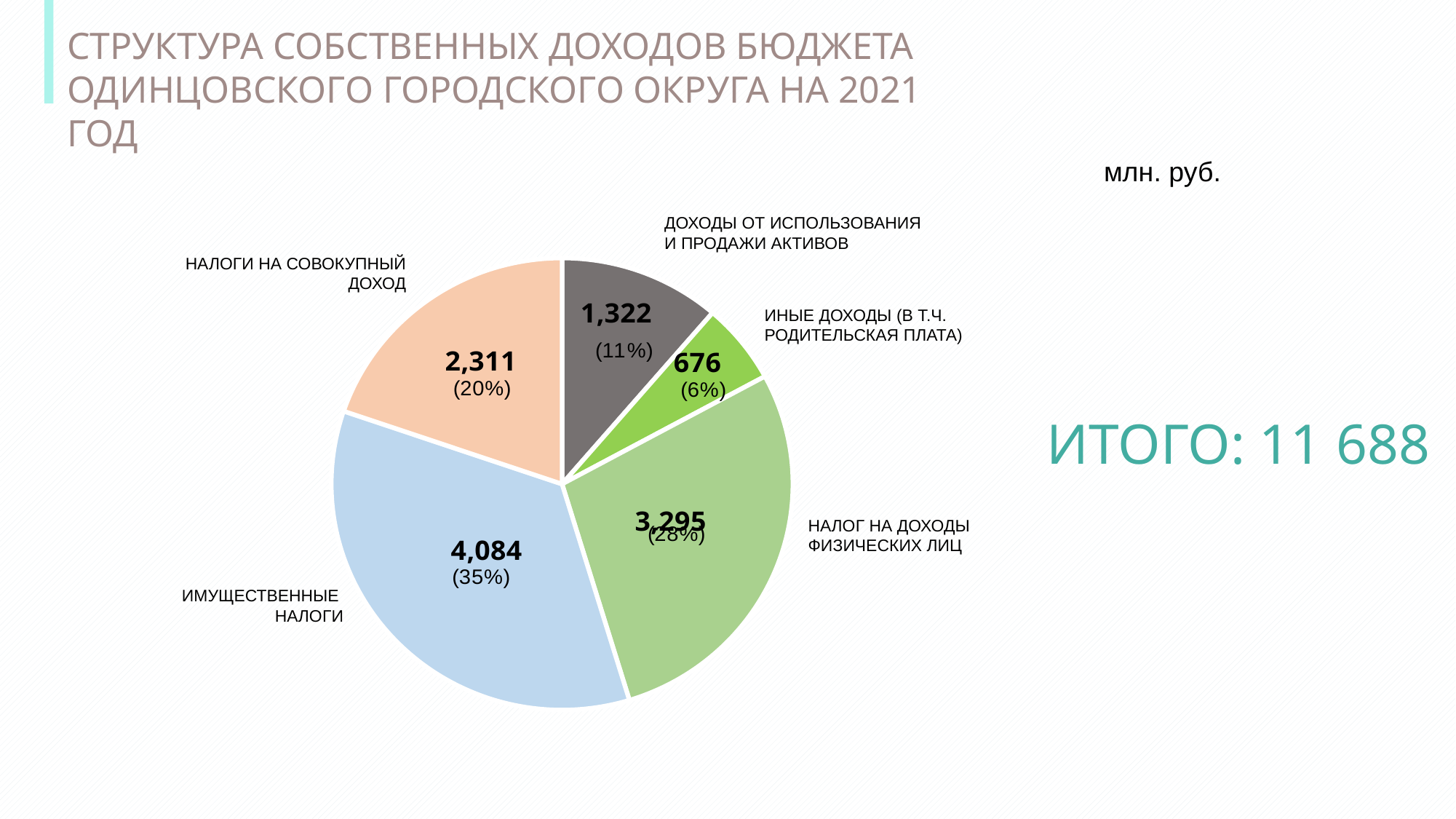
What is the value for НАЛОГ НА ДОХОДЫ ФИЗИЧЕСКИХ ЛИЦ? 3,295 Which category has the largest slice? ИМУЩЕСТВЕННЫЕ НАЛОГИ What is the value for ИМУЩЕСТВЕННЫЕ НАЛОГИ? 4,084 What is the value for ДОХОДЫ ОТ ИСПОЛЬЗОВАНИЯ И ПРОДАЖИ АКТИВОВ? 1,322 What share of the pie does НАЛОГ НА ДОХОДЫ ФИЗИЧЕСКИХ ЛИЦ represent? 28% Which is larger, the value for НАЛОГИ НА СОВОКУПНЫЙ ДОХОД or the value for ДОХОДЫ ОТ ИСПОЛЬЗОВАНИЯ И ПРОДАЖИ АКТИВОВ? НАЛОГИ НА СОВОКУПНЫЙ ДОХОД What is the value for НАЛОГИ НА СОВОКУПНЫЙ ДОХОД? 2,311 How many slices does the pie chart have? 5 What is the difference between the values for ИМУЩЕСТВЕННЫЕ НАЛОГИ and НАЛОГИ НА СОВОКУПНЫЙ ДОХОД? 1,773 What kind of chart is shown on the slide? pie chart What is the value for ИНЫЕ ДОХОДЫ (В Т.Ч. РОДИТЕЛЬСКАЯ ПЛАТА)? 676 Which category has the smallest slice? ИНЫЕ ДОХОДЫ (В Т.Ч. РОДИТЕЛЬСКАЯ ПЛАТА)